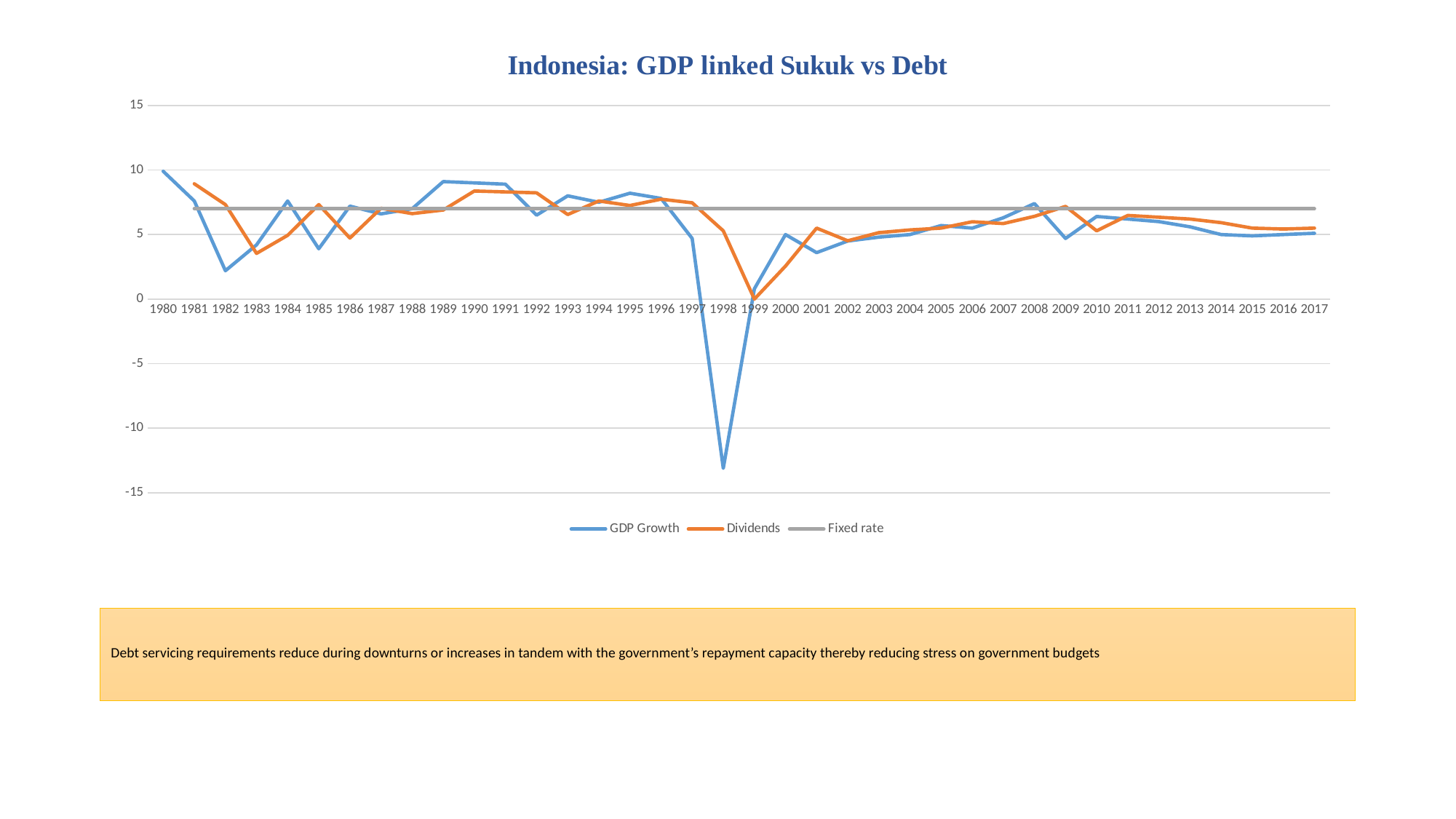
How many series does the legend list? 3 What is the title of the chart? Indonesia: GDP linked Sukuk vs Debt In 1998, which is larger: GDP Growth or Dividends? Dividends What are the three series listed in the legend? GDP Growth, Dividends, Fixed rate How many years are shown on the x axis? 38 Does GDP Growth rise or fall from 1997 to 1998? fall Is the Dividends value for 1981 greater or less than 5? greater Is the GDP Growth value for 1982 greater or less than 5? less What kind of chart is shown on the slide? line chart Is the GDP Growth value for 1998 greater or less than -10? less In which year is GDP Growth at its lowest? 1998